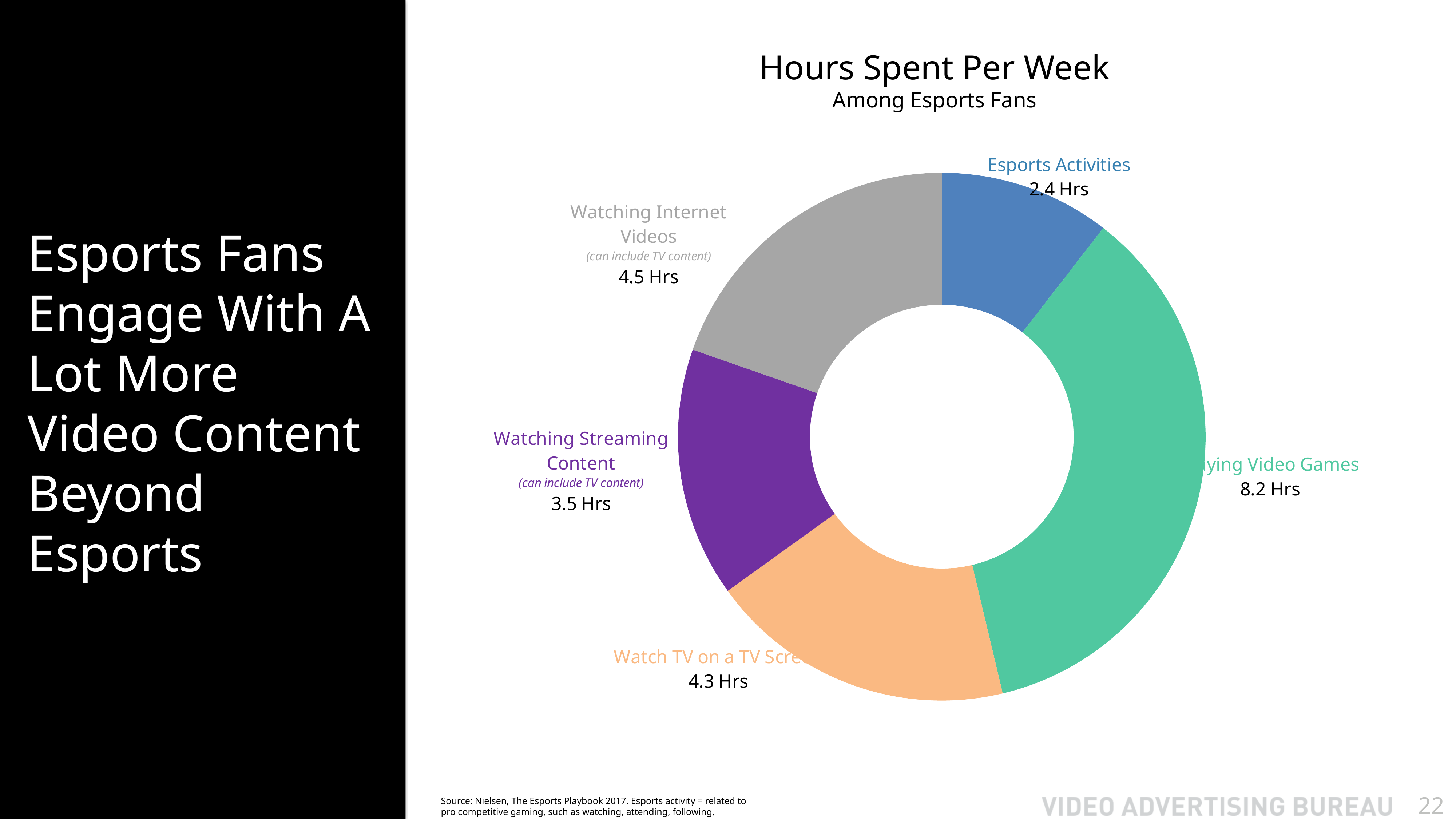
What kind of chart is used to show hours spent per week? Donut (pie) chart Which activity has the lowest hours spent per week? Esports Activities How many hours per week do esports fans spend on Esports Activities? 2.4 Hrs How many hours per week do esports fans spend Watching Streaming Content? 3.5 Hrs How many hours per week do esports fans spend watching TV on a TV screen? 4.3 Hrs Which activity has the highest hours spent per week? Playing Video Games How many activity categories are shown in the chart? 5 How many hours per week do esports fans spend Playing Video Games? 8.2 Hrs Which has more hours per week: Watching Streaming Content or Watching Internet Videos? Watching Internet Videos How many hours per week do esports fans spend Watching Internet Videos? 4.5 Hrs What is the difference in hours per week between Playing Video Games and Esports Activities? 5.8 Hrs What is the difference in hours per week between Watching Internet Videos and Watching Streaming Content? 1.0 Hrs